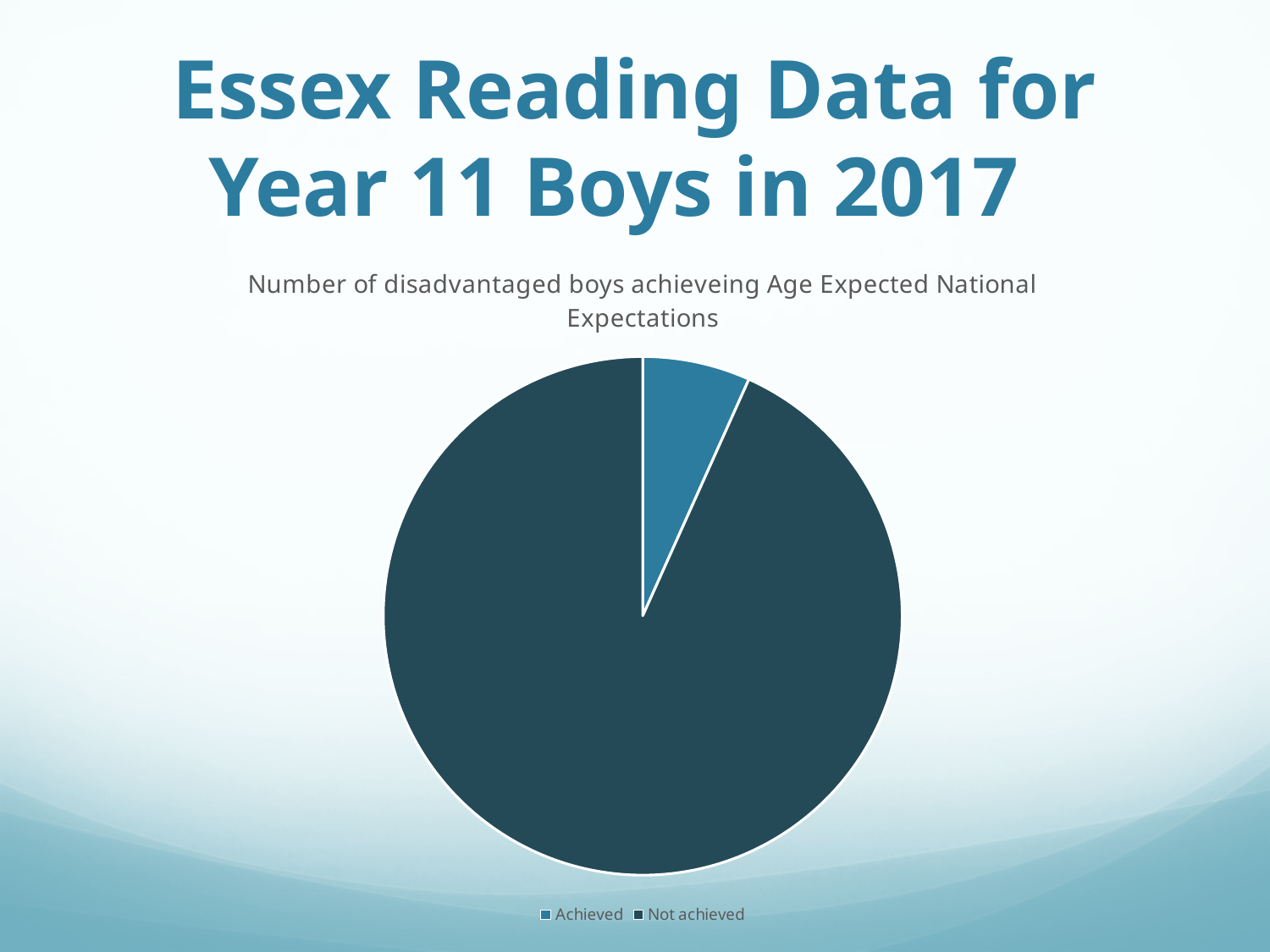
How many slices does the pie chart have? 2 What are the two categories listed in the legend of the pie chart? Achieved and Not achieved Which slice is larger, Achieved or Not achieved? Not achieved What is the title of the pie chart? Number of disadvantaged boys achieveing Age Expected National Expectations How many entries does the legend of the pie chart list? 2 Which category has the largest slice of the pie chart? Not achieved Which category has the smallest slice of the pie chart? Achieved What kind of chart is shown on the slide? Pie chart